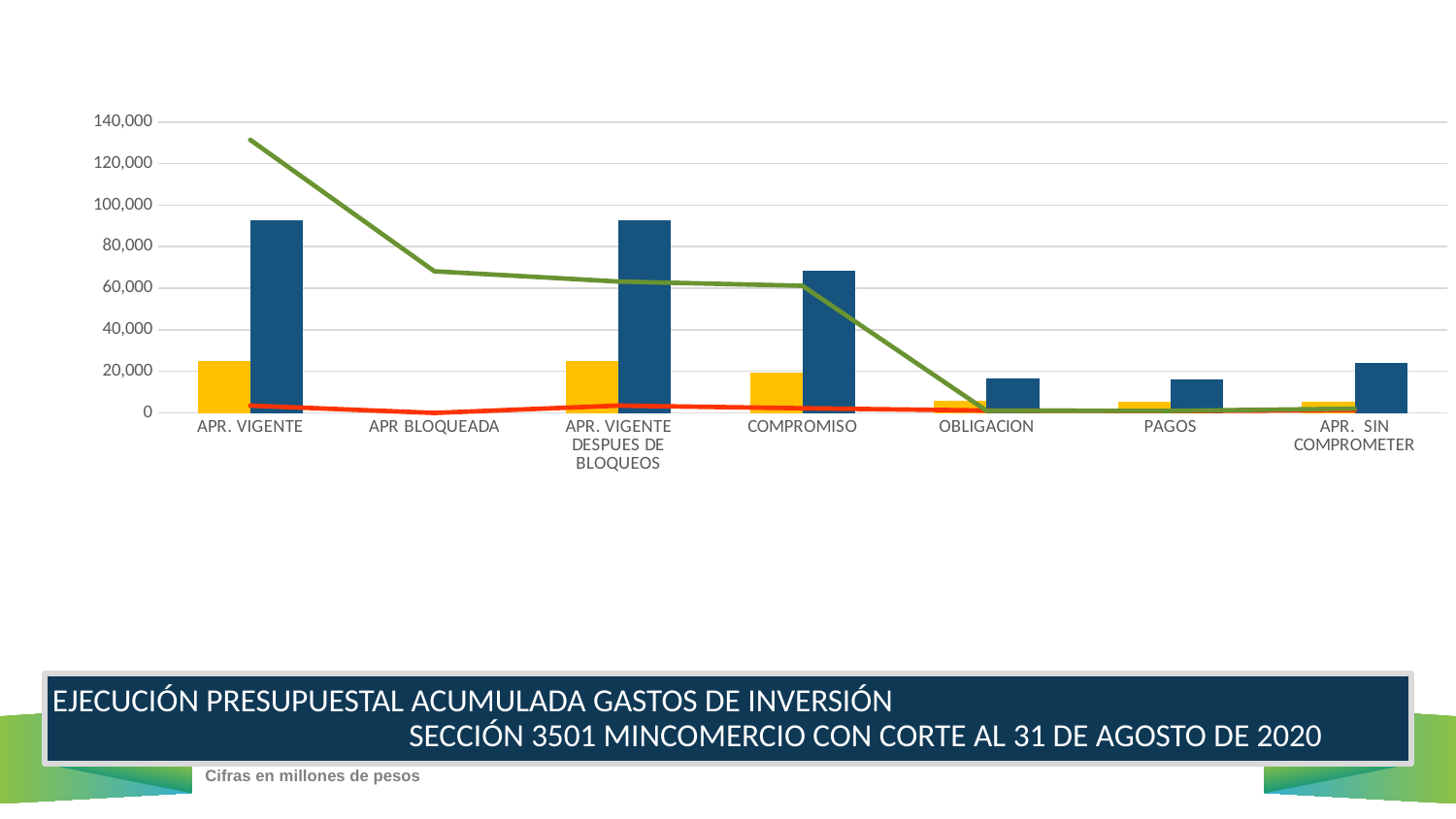
How many categories are shown on the x axis of the chart? 7 What kind of chart is shown on the slide? A combination bar and line chart Is the blue bar for APR. VIGENTE greater or less than 80,000? greater What is the highest value shown on the vertical axis of the chart? 140,000 Is the green line value at APR. VIGENTE greater or less than 120,000? greater According to the note below the chart, in what units are the figures expressed? Millones de pesos Which is larger, the yellow bar for APR. VIGENTE or the yellow bar for COMPROMISO? APR. VIGENTE Is the blue bar for COMPROMISO greater or less than 60,000? greater Does the green line rise or fall from APR. VIGENTE to OBLIGACION? fall Which is larger, the blue bar for COMPROMISO or the blue bar for OBLIGACION? COMPROMISO